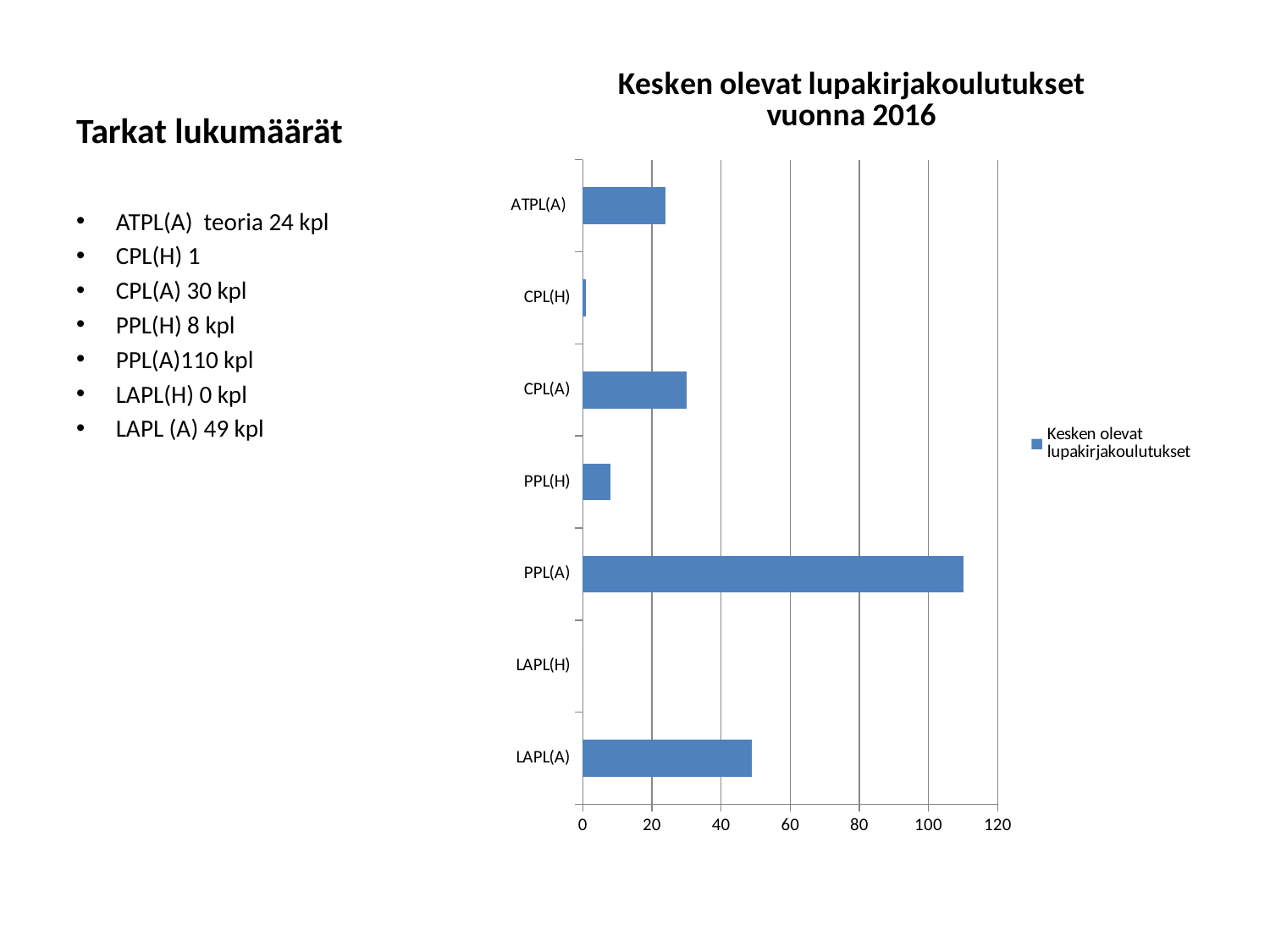
Which is larger, the value for CPL(A) or the value for ATPL(A)? CPL(A) What is the value for PPL(A)? 110 What is the value for CPL(A)? 30 What is the value for LAPL(A)? 49 What is the difference between the values for PPL(A) and CPL(A)? 80 How many series does the legend list? 1 Which category has the highest value in the chart? PPL(A) What is the title of the chart? Kesken olevat lupakirjakoulutukset vuonna 2016 What kind of chart is shown on the slide? bar chart Is the value for LAPL(A) greater or less than 40? greater How many categories are plotted in the chart? 7 Which category has the lowest value in the chart? LAPL(H)